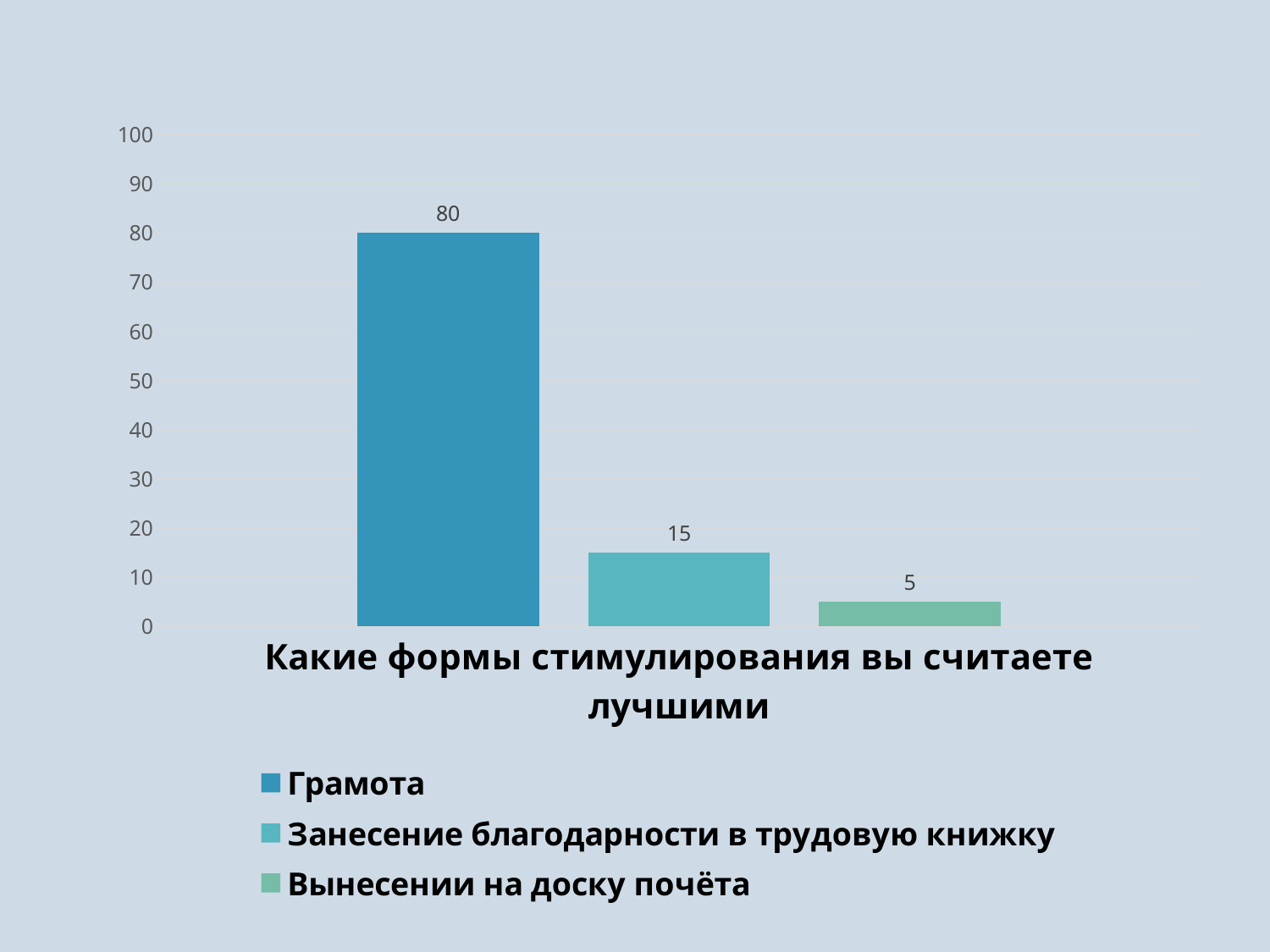
What is the value for Вынесении на доску почёта? 5 What is the difference between the values for Занесение благодарности в трудовую книжку and Вынесении на доску почёта? 10 What kind of chart is shown on the slide? bar chart Which category has the lowest value? Вынесении на доску почёта What is the title of the chart? Какие формы стимулирования вы считаете лучшими What is the value for Занесение благодарности в трудовую книжку? 15 What is the difference between the values for Грамота and Занесение благодарности в трудовую книжку? 65 How many bars are plotted on the chart? 3 Which category has the highest value? Грамота What is the value for Грамота? 80 Which is larger, the value for Занесение благодарности в трудовую книжку or the value for Вынесении на доску почёта? Занесение благодарности в трудовую книжку Is the value for Грамота greater or less than 50? greater